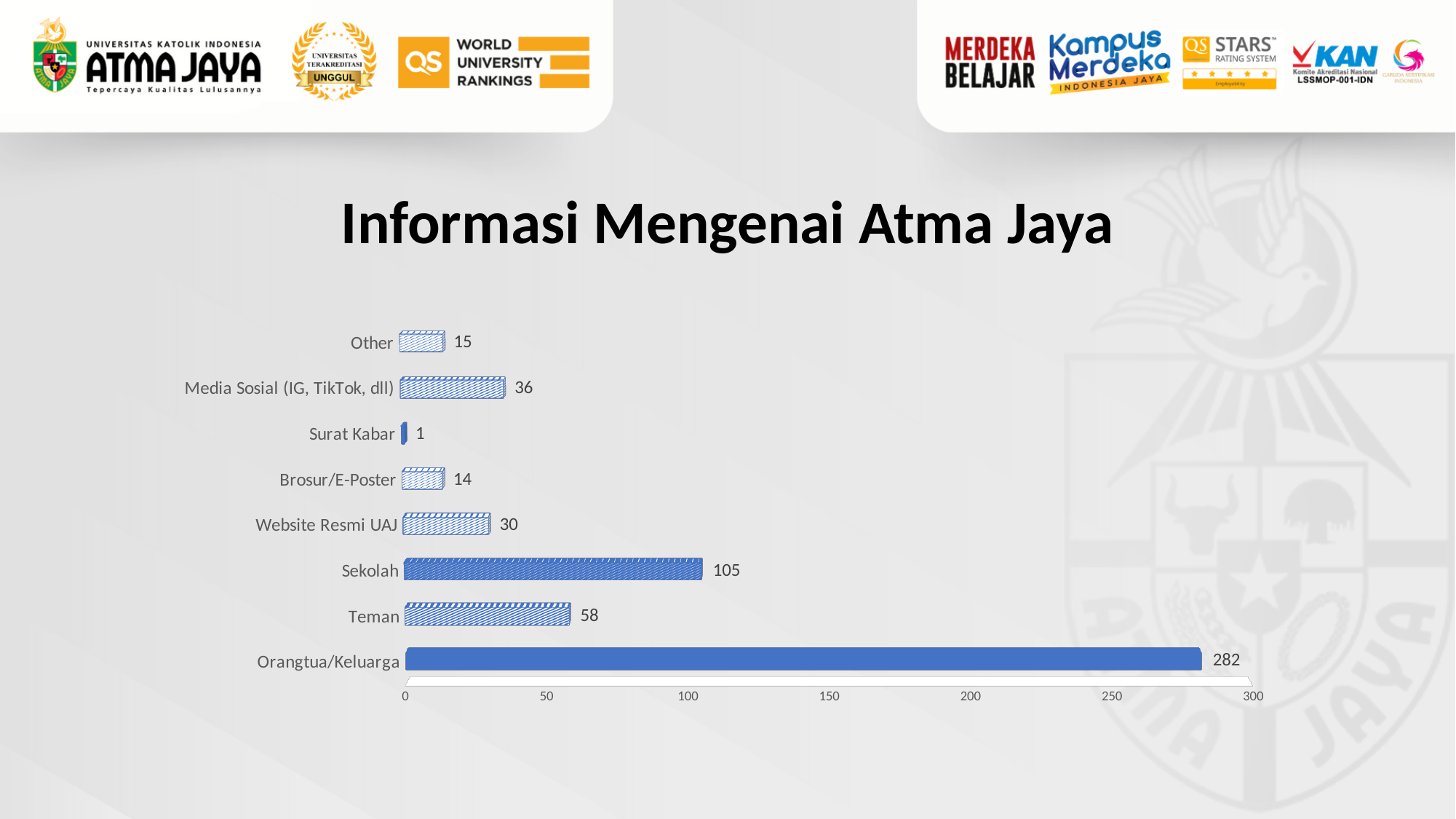
Which category has the lowest value? Surat Kabar What is the difference between the values for Orangtua/Keluarga and Sekolah? 177 How many categories are shown in the chart? 8 What kind of chart is shown on the slide? bar chart Which is larger, the value for Other or the value for Brosur/E-Poster? Other What is the value for Orangtua/Keluarga? 282 What is the title of the slide? Informasi Mengenai Atma Jaya What is the value for Sekolah? 105 What is the value for Media Sosial (IG, TikTok, dll)? 36 What is the difference between the values for Teman and Website Resmi UAJ? 28 Which category has the highest value? Orangtua/Keluarga Is the value for Sekolah greater or less than 100? greater